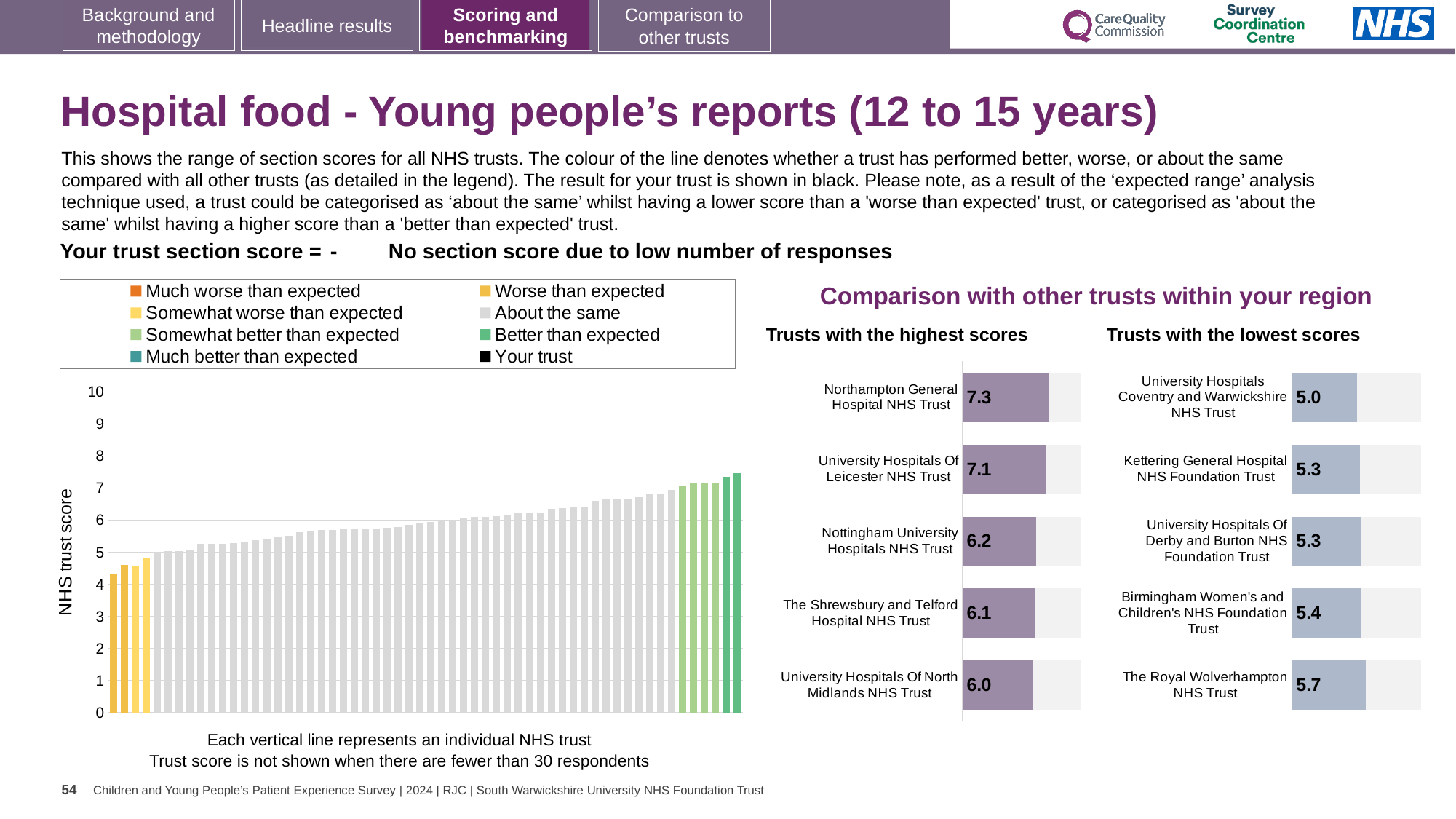
In the 'Trusts with the highest scores' chart, what is the score for University Hospitals Of North Midlands NHS Trust? 6.0 In the 'Trusts with the highest scores' chart, which trust has the highest score? Northampton General Hospital NHS Trust In the 'NHS trust score' chart on the left, do the bar values rise or fall from left to right? Rise In the 'Trusts with the lowest scores' chart, which trust has the lowest score? University Hospitals Coventry and Warwickshire NHS Trust In the 'Trusts with the highest scores' chart, what is the difference between the scores of Northampton General Hospital NHS Trust and Nottingham University Hospitals NHS Trust? 1.1 How many trusts are shown in the 'Trusts with the lowest scores' chart? 5 What type of chart is the 'NHS trust score' chart on the left of the slide? Bar chart In the 'Trusts with the highest scores' chart, what is the score for Northampton General Hospital NHS Trust? 7.3 In the 'Trusts with the lowest scores' chart, which is larger: the score for Birmingham Women's and Children's NHS Foundation Trust or Kettering General Hospital NHS Foundation Trust? Birmingham Women's and Children's NHS Foundation Trust How many entries does the legend of the 'NHS trust score' chart on the left list? 8 In the 'NHS trust score' chart on the left, is the value of the leftmost bar greater or less than 5? less In the 'Trusts with the lowest scores' chart, what is the score for The Royal Wolverhampton NHS Trust? 5.7